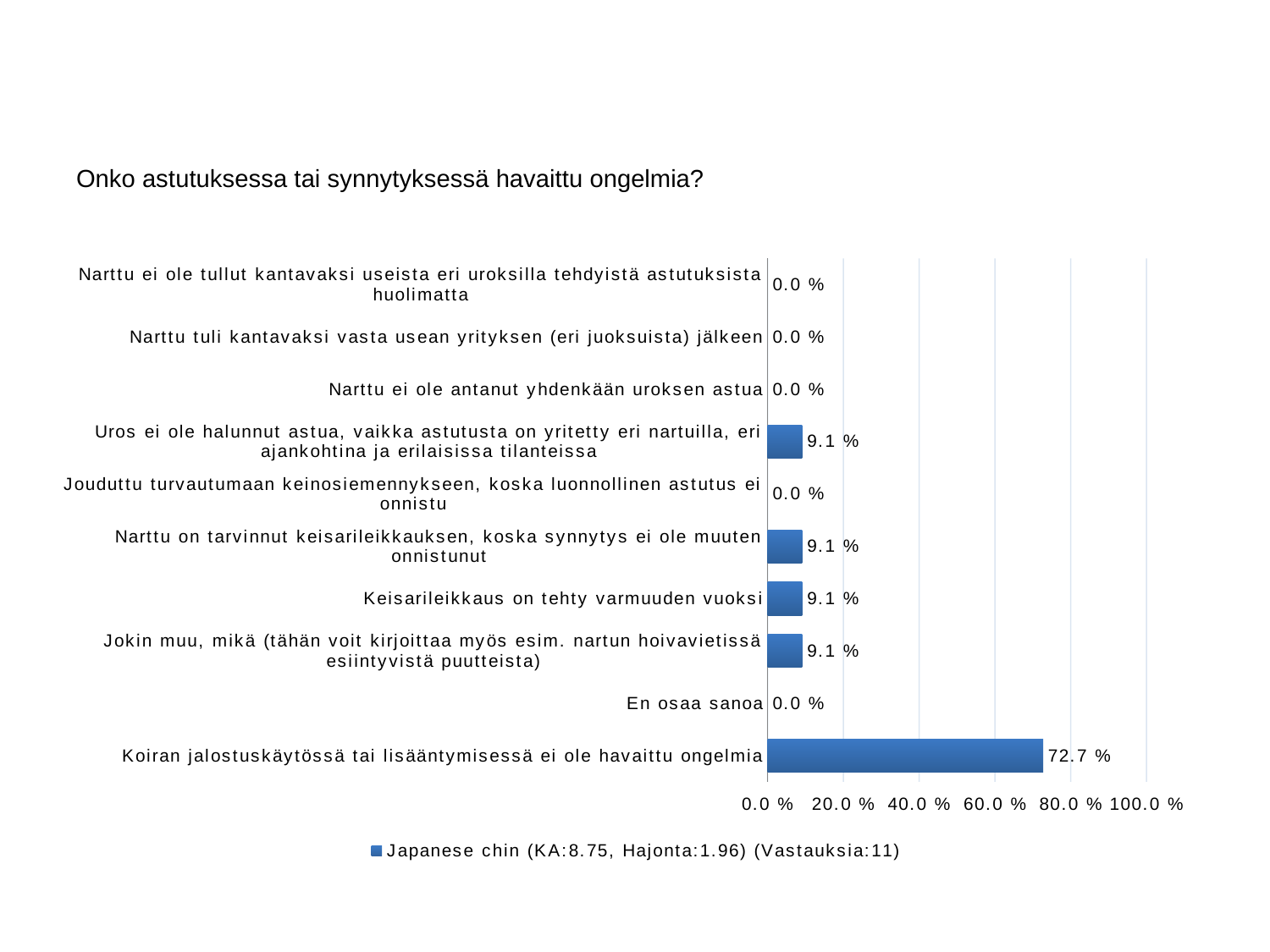
Is the value for "Koiran jalostuskäytössä tai lisääntymisessä ei ole havaittu ongelmia" greater or less than 60.0 %? greater What kind of chart is shown on the slide? bar chart What value is shown for "Narttu ei ole antanut yhdenkään uroksen astua"? 0.0 % What value is shown for "Koiran jalostuskäytössä tai lisääntymisessä ei ole havaittu ongelmia"? 72.7 % Which is larger: the value for "Keisarileikkaus on tehty varmuuden vuoksi" or the value for "En osaa sanoa"? Keisarileikkaus on tehty varmuuden vuoksi How many series does the legend list? 1 How many categories are shown on the chart? 10 Which category has the highest value? Koiran jalostuskäytössä tai lisääntymisessä ei ole havaittu ongelmia What is the title of the chart? Onko astutuksessa tai synnytyksessä havaittu ongelmia? What value is shown for "Keisarileikkaus on tehty varmuuden vuoksi"? 9.1 % What is the difference between the value for "Koiran jalostuskäytössä tai lisääntymisessä ei ole havaittu ongelmia" and the value for "Keisarileikkaus on tehty varmuuden vuoksi"? 63.6 % What value is shown for "En osaa sanoa"? 0.0 %